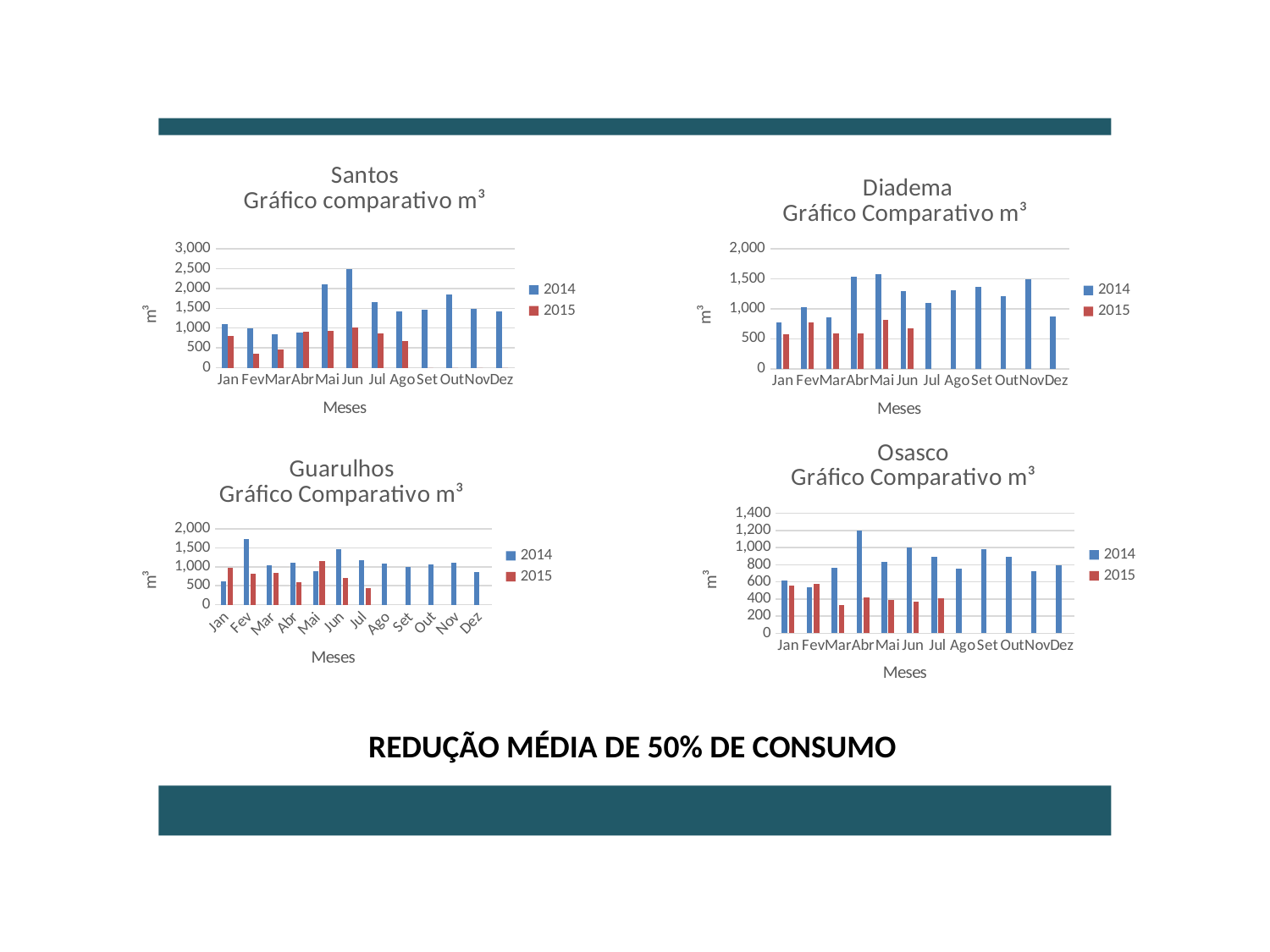
In the Guarulhos chart, which month has the highest 2014 value? Fev In the Santos chart, which month has the highest 2014 value? Jun What kind of chart is the Santos Gráfico comparativo m³? bar chart In the Diadema chart, which month has the lowest 2014 value? Jan In the Guarulhos chart, is the 2015 value for Jul greater or less than 500? less In the Santos chart, is the 2015 value for Fev greater or less than 500? less How many months are shown on the x axis of the Osasco chart? 12 In the Diadema chart, is the 2015 value for Mai greater or less than 500? greater In the Osasco chart, which is larger for Mar: the 2014 value or the 2015 value? 2014 In the Osasco chart, which month has the highest 2014 value? Abr How many series does the legend of the Diadema chart list? 2